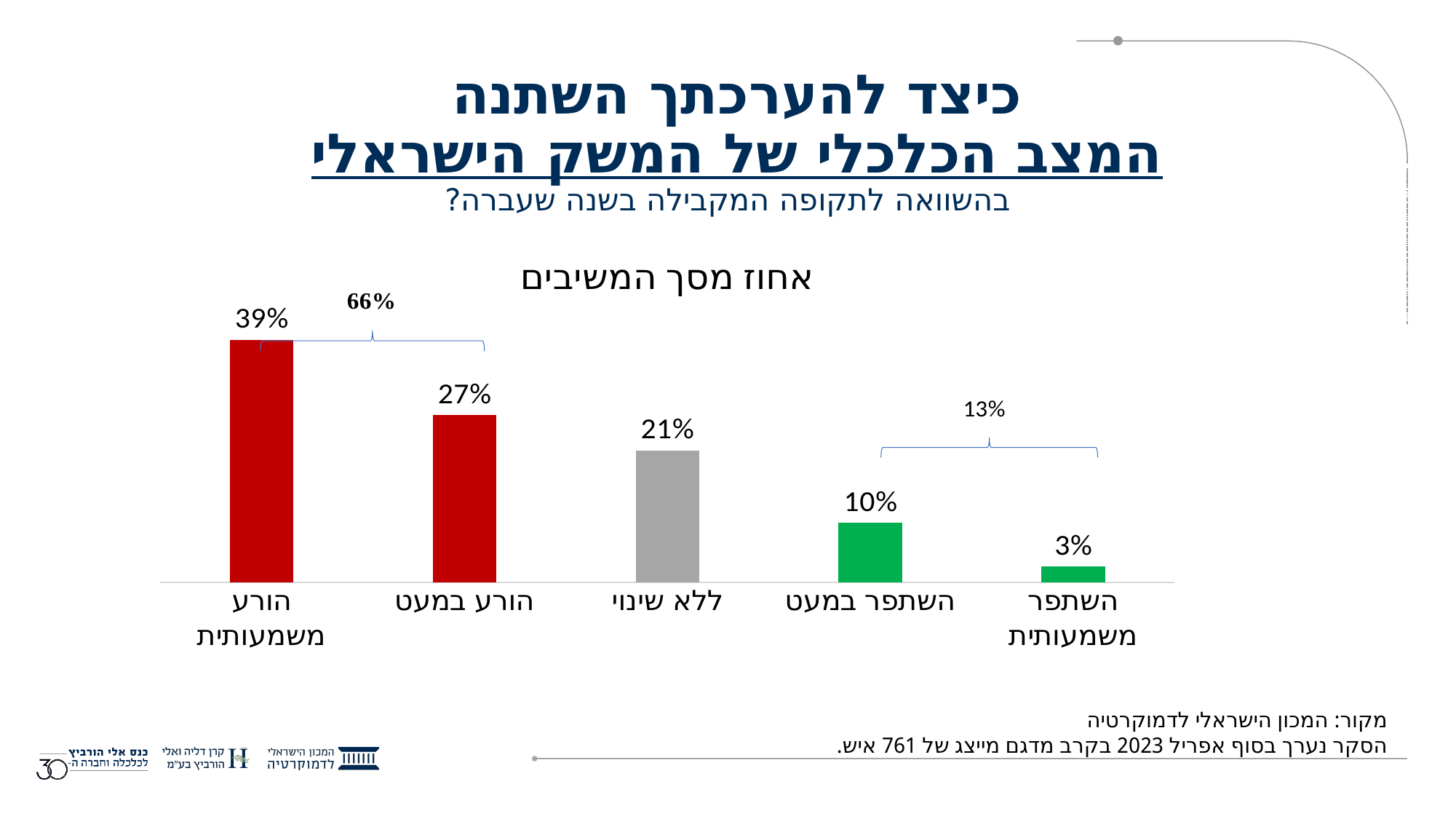
How many categories are shown in the chart? 5 What is the title of the chart? אחוז מסך המשיבים Which category has the highest value? הורע משמעותית Which is larger, the value for "ללא שינוי" or the value for "השתפר במעט"? ללא שינוי What is the difference between the values for "הורע משמעותית" and "הורע במעט"? 12% What combined percentage is shown by the bracket over the two red bars ("הורע משמעותית" and "הורע במעט")? 66% What value is shown for the category "הורע משמעותית"? 39% What value is shown for the category "ללא שינוי"? 21% What kind of chart is shown on the slide? Bar chart What value is shown for the category "השתפר משמעותית"? 3% What value is shown for the category "השתפר במעט"? 10% Which category has the lowest value? השתפר משמעותית